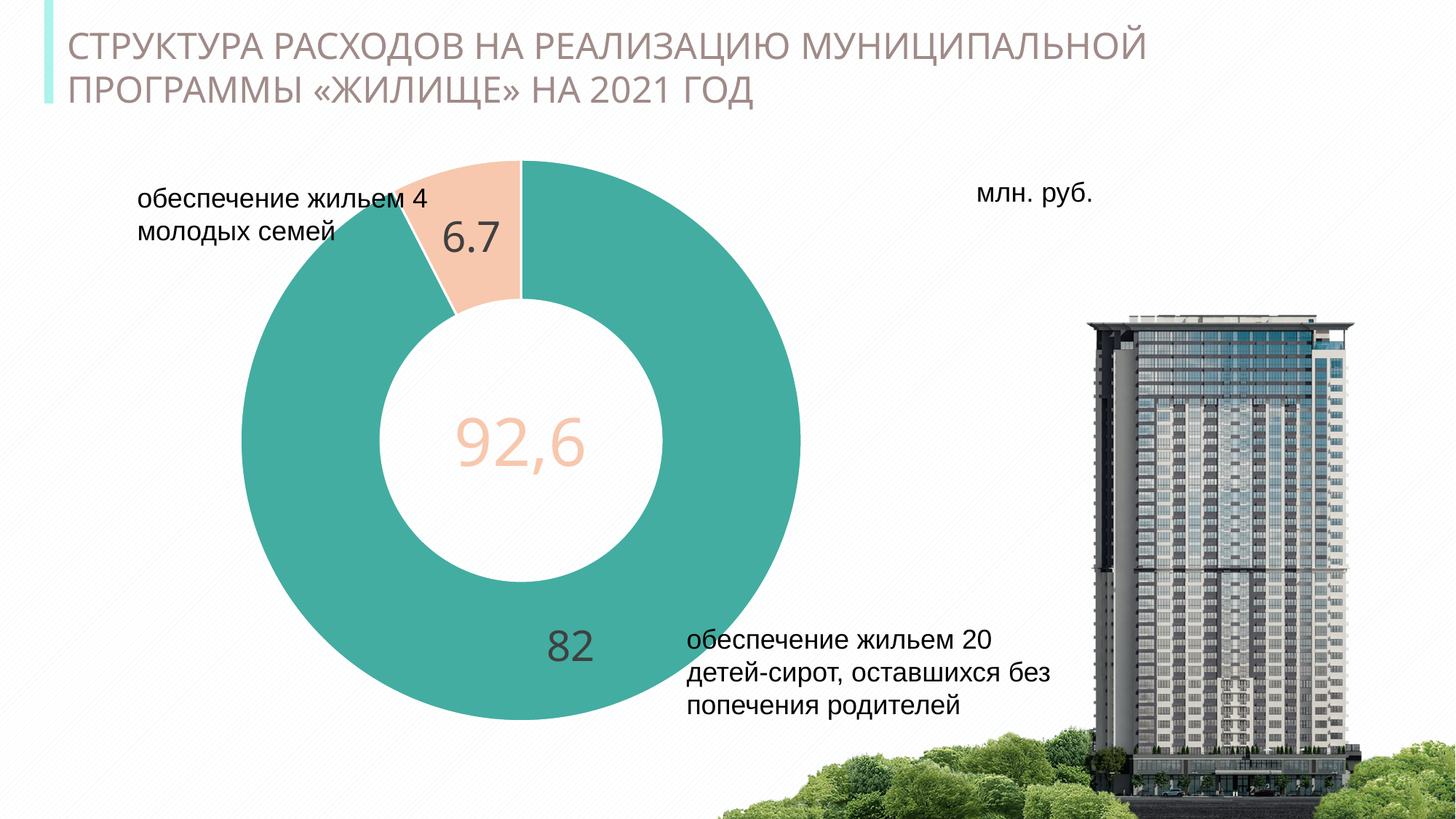
Which category has the largest slice of the chart? обеспечение жильем 20 детей-сирот, оставшихся без попечения родителей How many slices does the chart have? 2 What is the value for providing housing to 4 young families (обеспечение жильем 4 молодых семей)? 6.7 What is the value for providing housing to 20 orphan children left without parental care (обеспечение жильем 20 детей-сирот)? 82 In what units are the chart values given? млн. руб. Which category has the smallest slice of the chart? обеспечение жильем 4 молодых семей What number is printed in the centre of the donut chart? 92,6 What kind of chart is shown on the slide? Pie (donut) chart What is the difference between the value for housing for 20 orphan children and the value for housing for 4 young families? 75.3 Which is larger: the value for housing for 20 orphan children or the value for housing for 4 young families? обеспечение жильем 20 детей-сирот